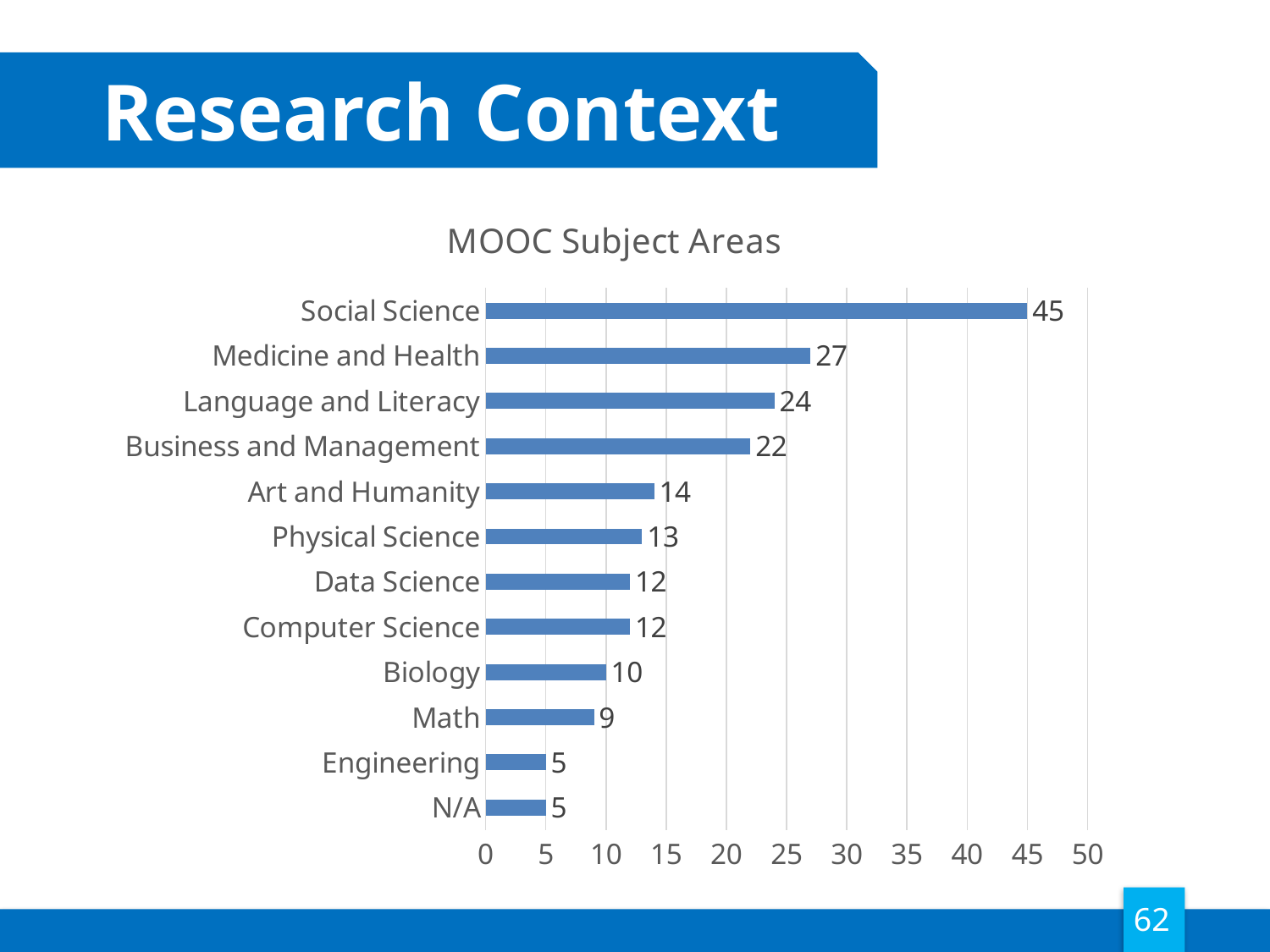
What is the difference between the values for Language and Literacy and Art and Humanity? 10 What is the value for Business and Management? 22 What is the title of the chart? MOOC Subject Areas What kind of chart is shown on the slide? Bar chart Is the value for Medicine and Health greater or less than 25? greater What is the difference between the values for Social Science and Medicine and Health? 18 Which subject area has the highest value? Social Science What is the value for Math? 9 How many subject areas are shown in the chart? 12 Which is larger, the value for Physical Science or the value for Biology? Physical Science What is the value for Social Science? 45 What is the value for Engineering? 5